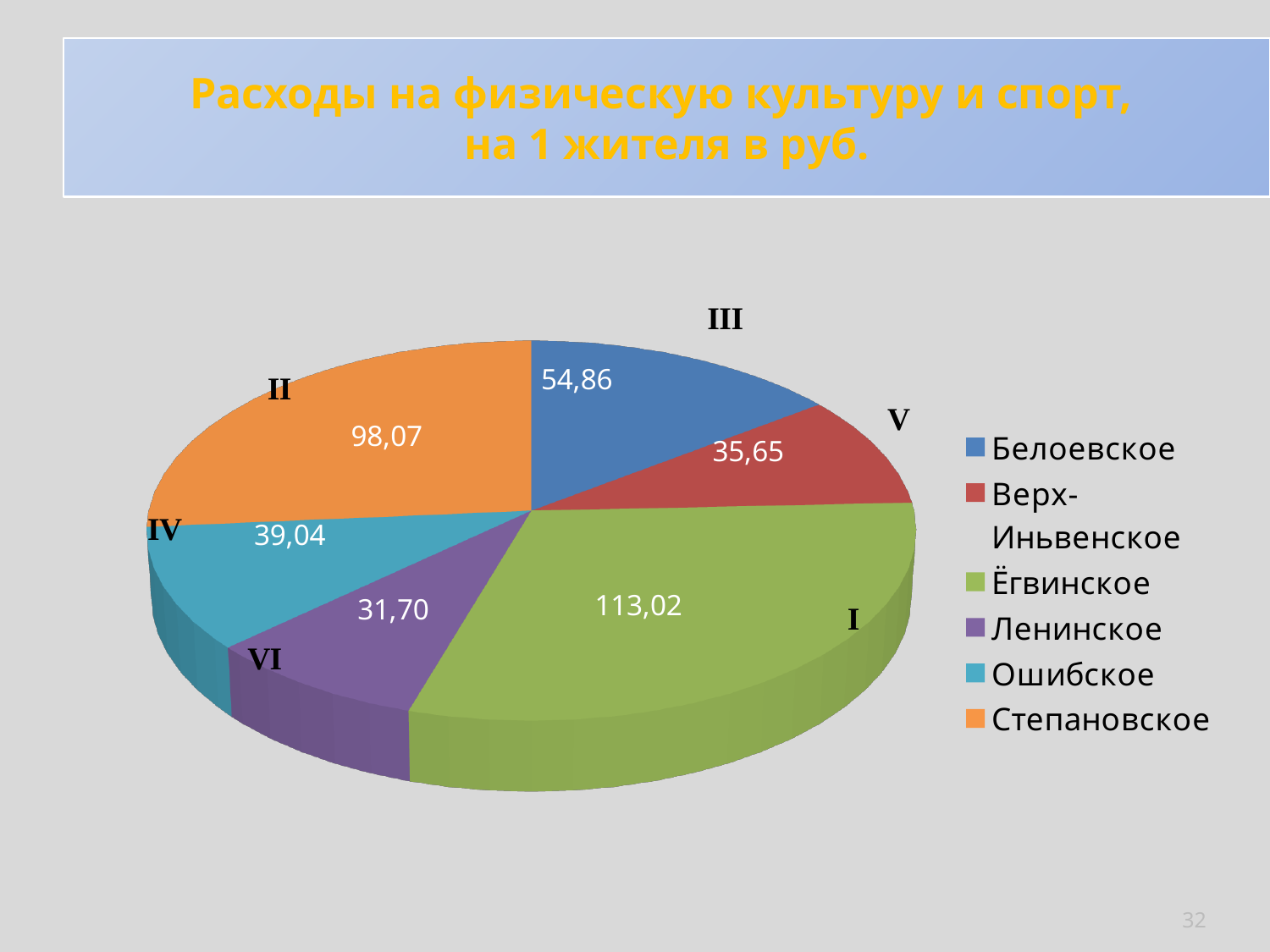
What type of chart is shown on the slide? Pie chart What is the value for Степановское? 98,07 Which category has the lowest value? Ленинское What is the value for Ёгвинское? 113,02 What is the difference between the values for Ёгвинское and Степановское? 14,95 What is the value for Ленинское? 31,70 What is the value for Ошибское? 39,04 Which is larger, the value for Ошибское or the value for Верх-Иньвенское? Ошибское Which category has the highest value? Ёгвинское What is the difference between the values for Белоевское and Верх-Иньвенское? 19,21 Which Roman numeral label is placed next to the Степановское slice? II How many categories does the legend list? 6